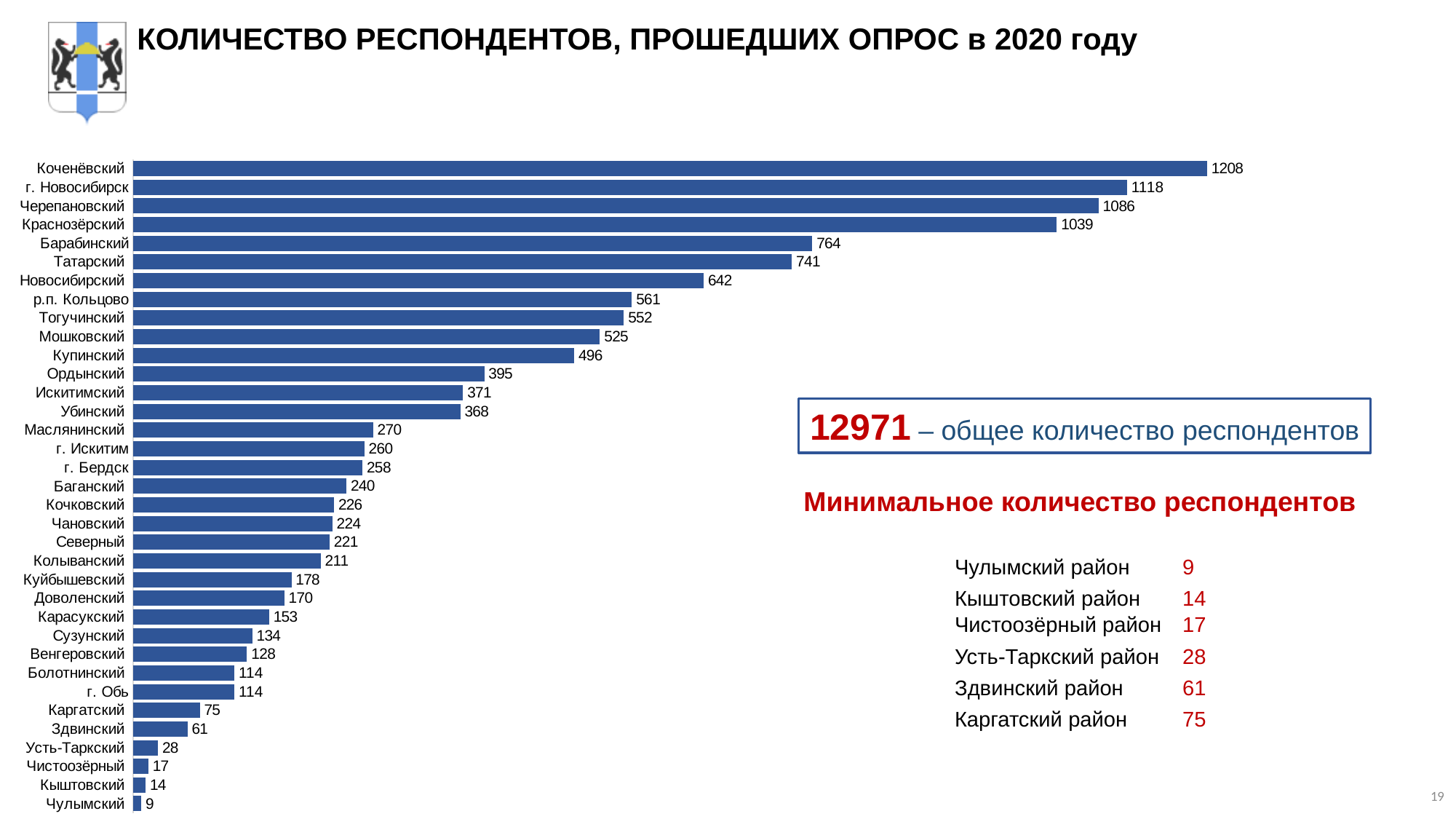
How many categories are shown in the bar chart? 35 What is the value for Татарский? 741 Which is larger, the value for Мошковский or the value for Купинский? Мошковский Which is larger, the value for Здвинский or the value for Каргатский? Каргатский How many respondents are shown for Коченёвский? 1208 What total number of respondents is stated in the box on the slide? 12971 What is the value for г. Новосибирск? 1118 What kind of chart is shown on the slide? bar chart What is the difference between the values for Барабинский and Татарский? 23 Which category has the lowest number of respondents? Чулымский What is the difference between the values for Коченёвский and г. Новосибирск? 90 Which category has the highest number of respondents? Коченёвский